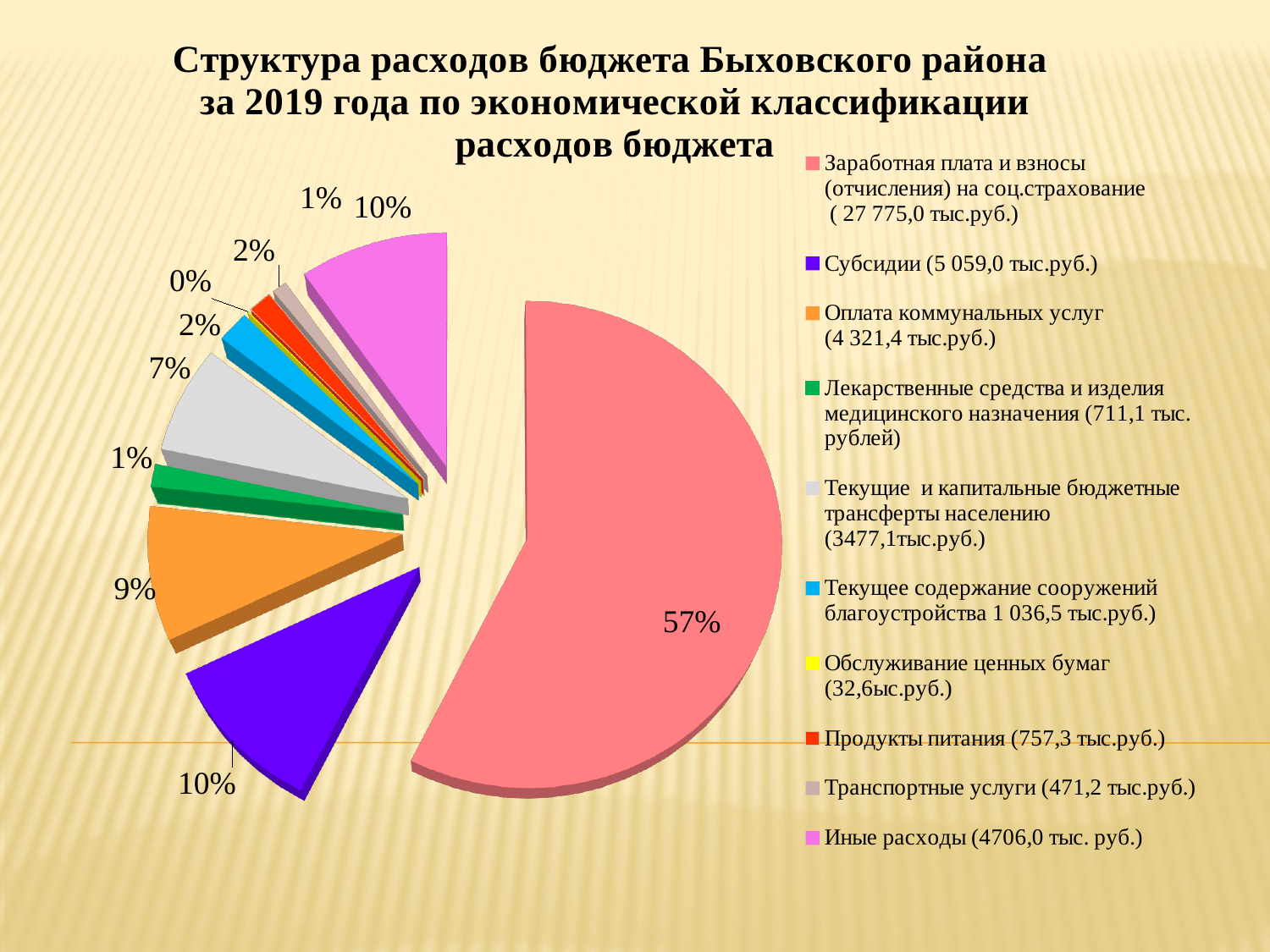
What is the difference in percentage points between the share for Заработная плата и взносы (отчисления) на соц.страхование and the share for Субсидии? 47 percentage points What share of the pie does Субсидии have? 10% How many slices does the pie chart have? 10 Which has a larger share of the pie, Оплата коммунальных услуг or Текущие и капитальные бюджетные трансферты населению? Оплата коммунальных услуг Which category has the smallest share of the pie? Обслуживание ценных бумаг What share of the pie does Оплата коммунальных услуг have? 9% Which category has the largest share of the pie? Заработная плата и взносы (отчисления) на соц.страхование What amount in thousand rubles is shown in the legend for Иные расходы? 4706,0 тыс. руб. What amount in thousand rubles is shown in the legend for Субсидии? 5 059,0 тыс.руб. What kind of chart is shown on the slide? pie chart What share of the pie does Заработная плата и взносы (отчисления) на соц.страхование have? 57%